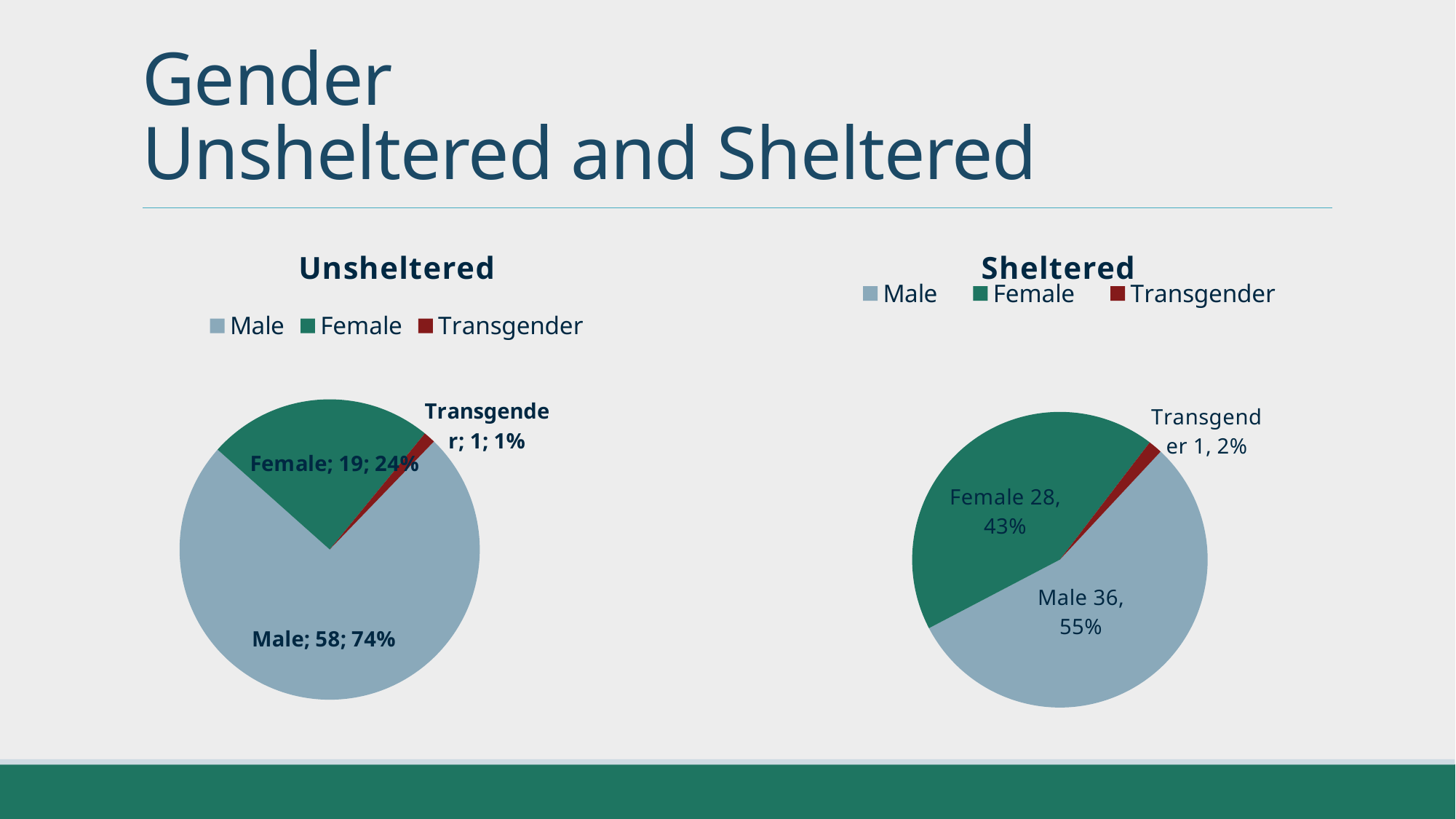
In the Sheltered chart, what percentage share does Male have? 55% In the Sheltered chart, what is the value for Female? 28 In the Sheltered chart, what is the value for Transgender? 1 In the Sheltered chart, which category has the smallest slice? Transgender How many categories does the Sheltered chart show? 3 In the Unsheltered chart, what is the difference between the Male and Female values? 39 In the Unsheltered chart, what percentage share does Female have? 24% In the Sheltered chart, which is larger, the Male value or the Female value? Male In the Unsheltered chart, what is the value for Male? 58 What kind of chart is the Unsheltered chart? Pie chart In the Unsheltered chart, which category has the largest slice? Male In the Sheltered chart, what colour is the Female slice? Green